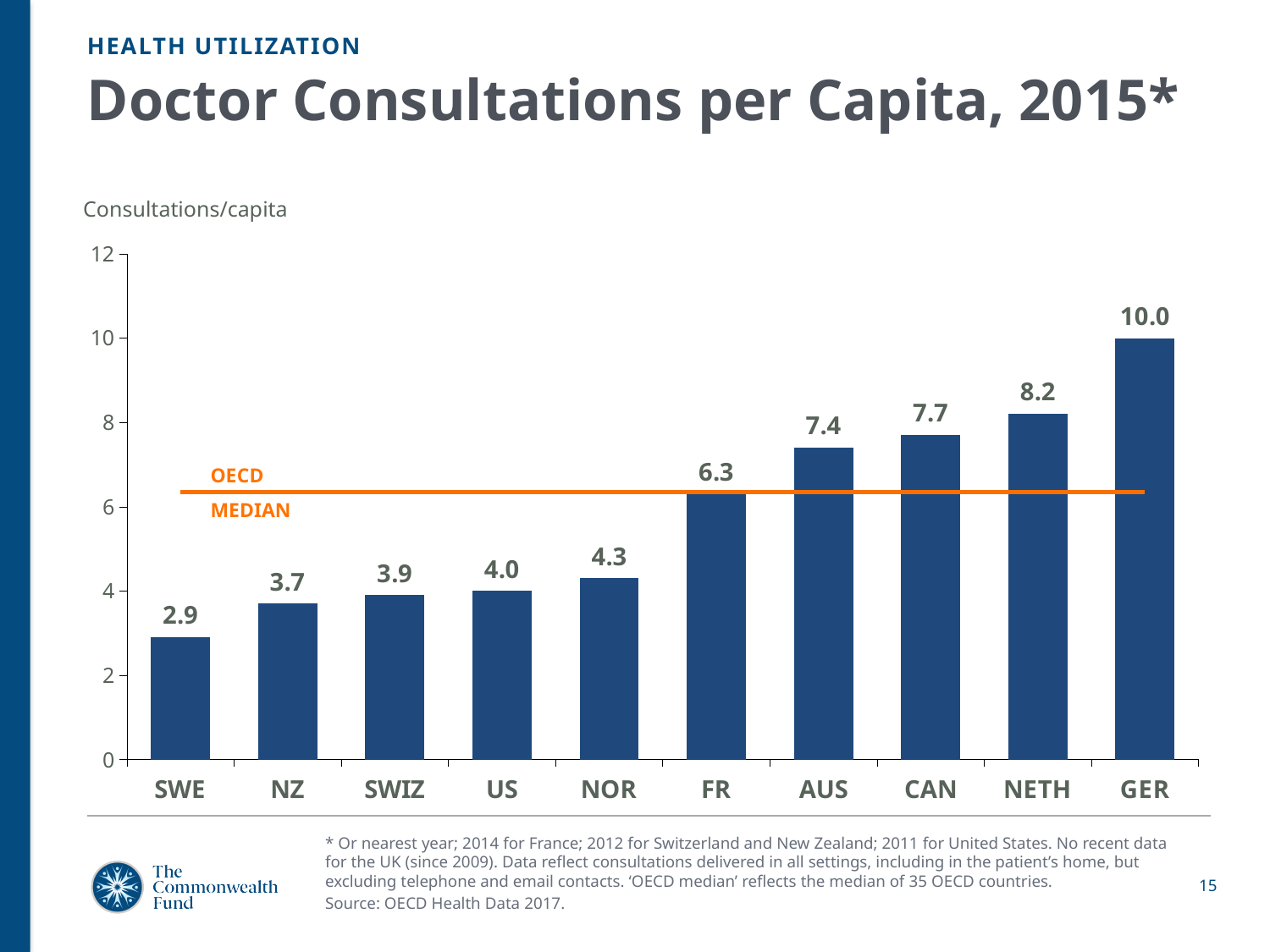
Is the value for Switzerland (SWIZ) greater or less than 4? less Which country has the lowest number of doctor consultations per capita? SWE What type of chart is used on this slide? Bar chart Which country has the highest number of doctor consultations per capita? GER What is the difference in consultations per capita between Germany (GER) and Sweden (SWE)? 7.1 What is the value shown for Canada (CAN)? 7.7 What is the number of doctor consultations per capita for Germany (GER)? 10.0 What is the number of doctor consultations per capita for the US? 4.0 Which has more doctor consultations per capita, Norway (NOR) or France (FR)? FR What does the orange horizontal line on the chart represent? OECD median How many countries are shown in the chart? 10 What is the difference in consultations per capita between the Netherlands (NETH) and Australia (AUS)? 0.8